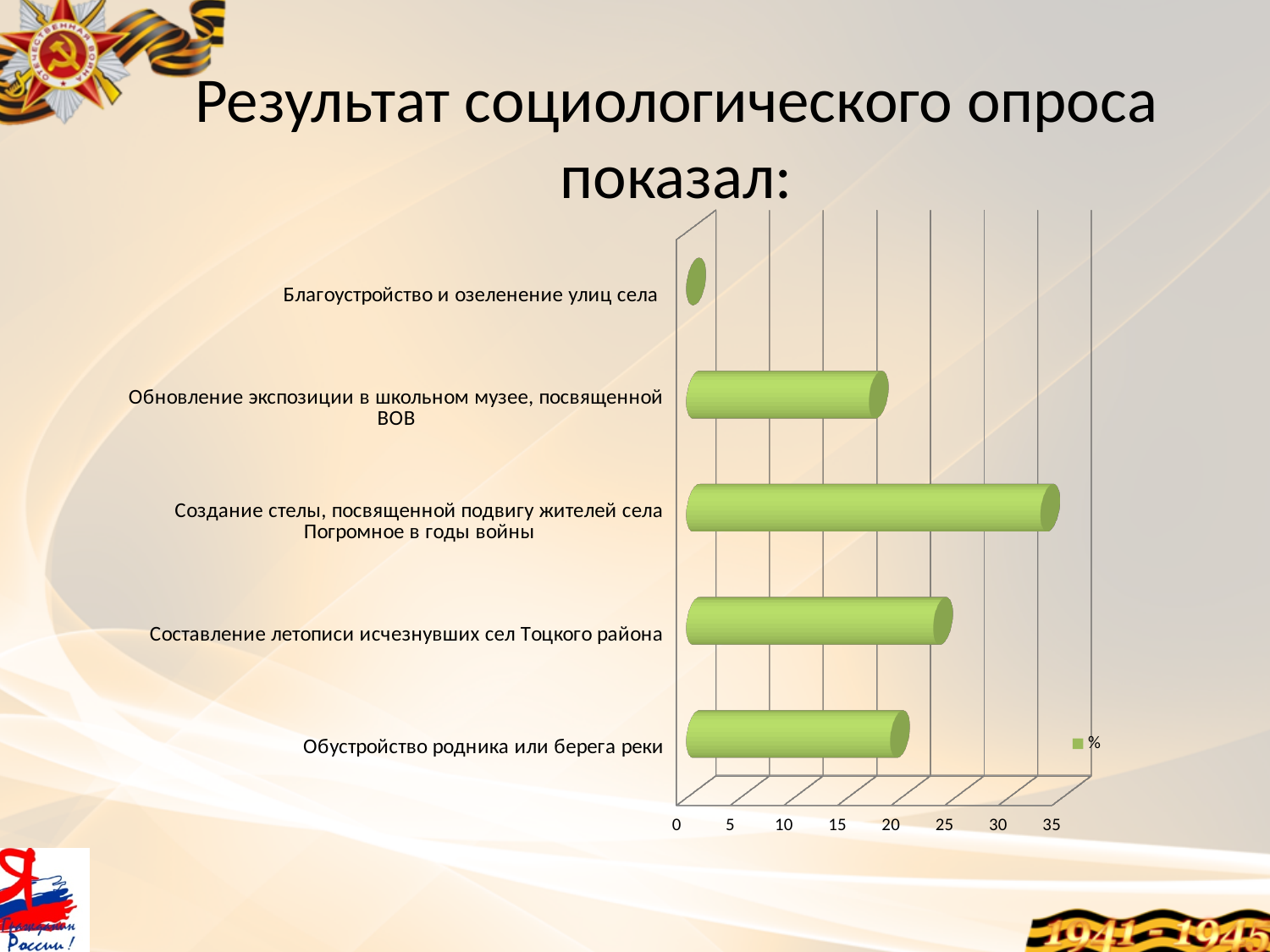
How many categories are plotted in the chart? 5 Is the value for "Благоустройство и озеленение улиц села" greater or less than 5? less Which is larger: the value for "Составление летописи исчезнувших сел Тоцкого района" or for "Обновление экспозиции в школьном музее, посвященной ВОВ"? Составление летописи исчезнувших сел Тоцкого района What is the title of the slide containing the chart? Результат социологического опроса показал: What is the legend entry shown for the series in the chart? % Is the value for "Составление летописи исчезнувших сел Тоцкого района" greater or less than 20? greater Which category has the highest value in the chart? Создание стелы, посвященной подвигу жителей села Погромное в годы войны Is the value for "Обновление экспозиции в школьном музее, посвященной ВОВ" greater or less than 10? greater What kind of chart is shown on the slide? bar chart How many series does the legend list? 1 Which category has the lowest value in the chart? Благоустройство и озеленение улиц села